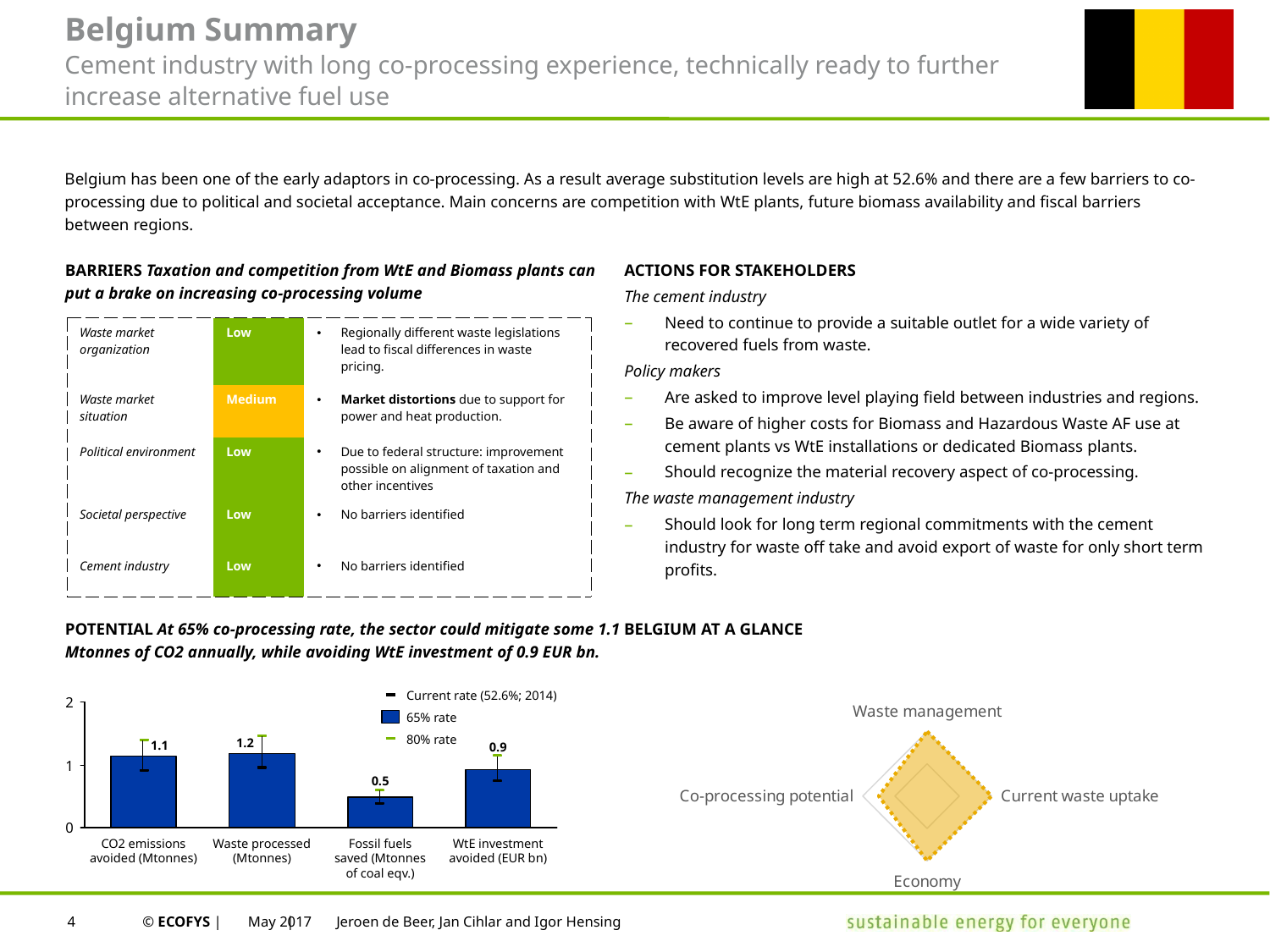
In the bar chart at the bottom left, what is the value for CO2 emissions avoided (Mtonnes) at the 65% rate? 1.1 In the bar chart at the bottom left, which is larger: the labelled value for CO2 emissions avoided or for WtE investment avoided? CO2 emissions avoided How many categories are shown on the x axis of the bar chart at the bottom left? 4 In the bar chart at the bottom left, what is the value for Fossil fuels saved (Mtonnes of coal eqv.) at the 65% rate? 0.5 In the bar chart at the bottom left, what is the value for WtE investment avoided (EUR bn) at the 65% rate? 0.9 How many entries does the legend of the bar chart at the bottom left list? 3 In the bar chart at the bottom left, what is the difference between the labelled values for Waste processed and CO2 emissions avoided? 0.1 What kind of chart is the 'Belgium at a glance' chart at the bottom right? Radar chart In the bar chart at the bottom left, what is the difference between the labelled values for CO2 emissions avoided and Fossil fuels saved? 0.6 In the bar chart at the bottom left, which category has the highest labelled bar value? Waste processed (Mtonnes) In the bar chart at the bottom left, which category has the lowest labelled bar value? Fossil fuels saved (Mtonnes of coal eqv.) In the bar chart at the bottom left, is the bar for Fossil fuels saved greater or less than 1? less